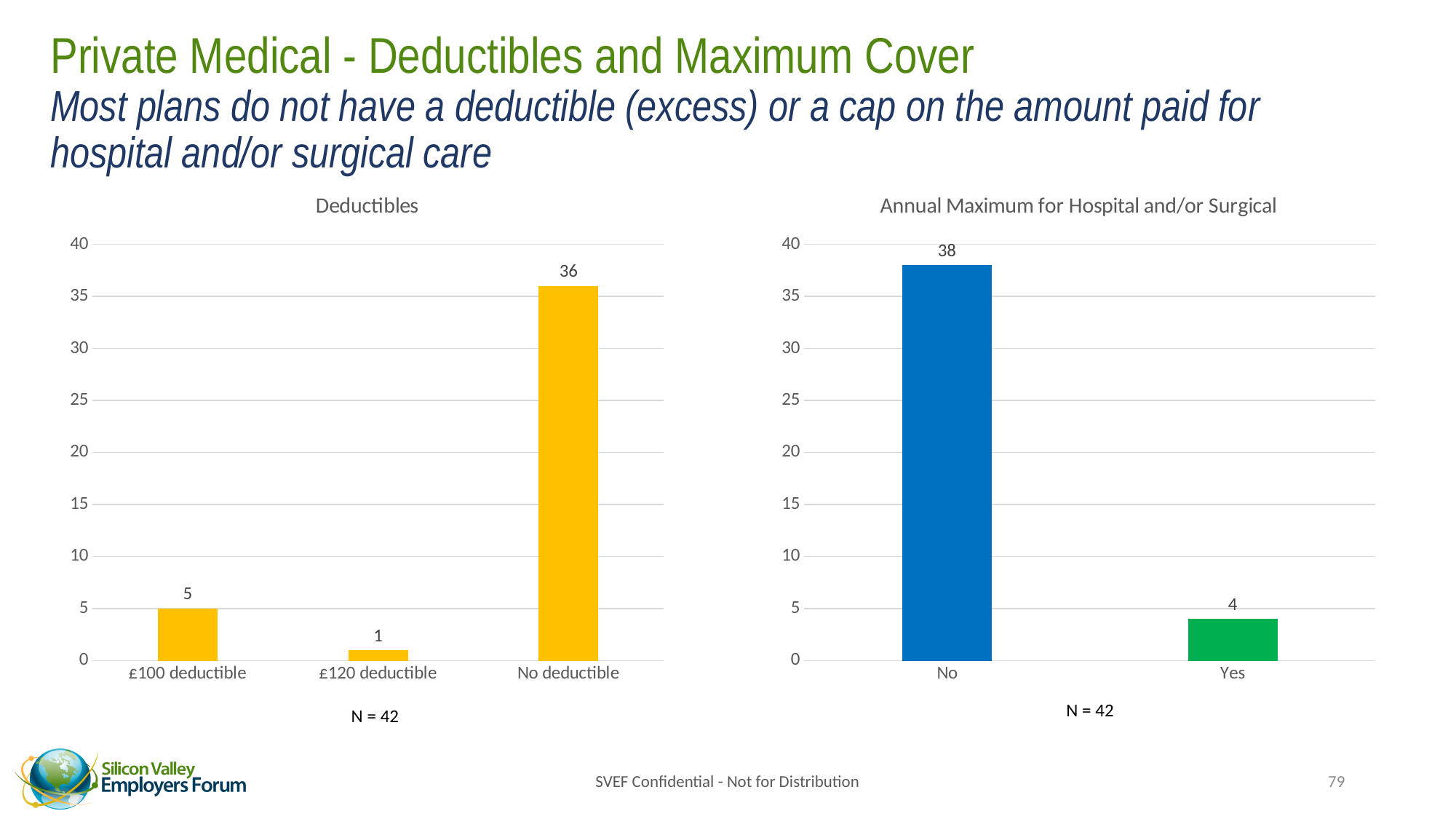
In the Deductibles chart, what is the value for No deductible? 36 In the Deductibles chart, is the value for No deductible greater or less than 35? greater In the Annual Maximum for Hospital and/or Surgical chart, what is the value for No? 38 In the Annual Maximum for Hospital and/or Surgical chart, which category has the highest value? No What is the title of the chart on the left side of the slide? Deductibles What kind of chart is the Annual Maximum for Hospital and/or Surgical chart? Bar chart In the Deductibles chart, which category has the lowest value? £120 deductible In the Deductibles chart, what is the difference between No deductible and £100 deductible? 31 In the Deductibles chart, how many categories are shown? 3 In the Annual Maximum for Hospital and/or Surgical chart, what is the value for Yes? 4 In the Deductibles chart, what is the value for £100 deductible? 5 In the Annual Maximum for Hospital and/or Surgical chart, what is the difference between No and Yes? 34